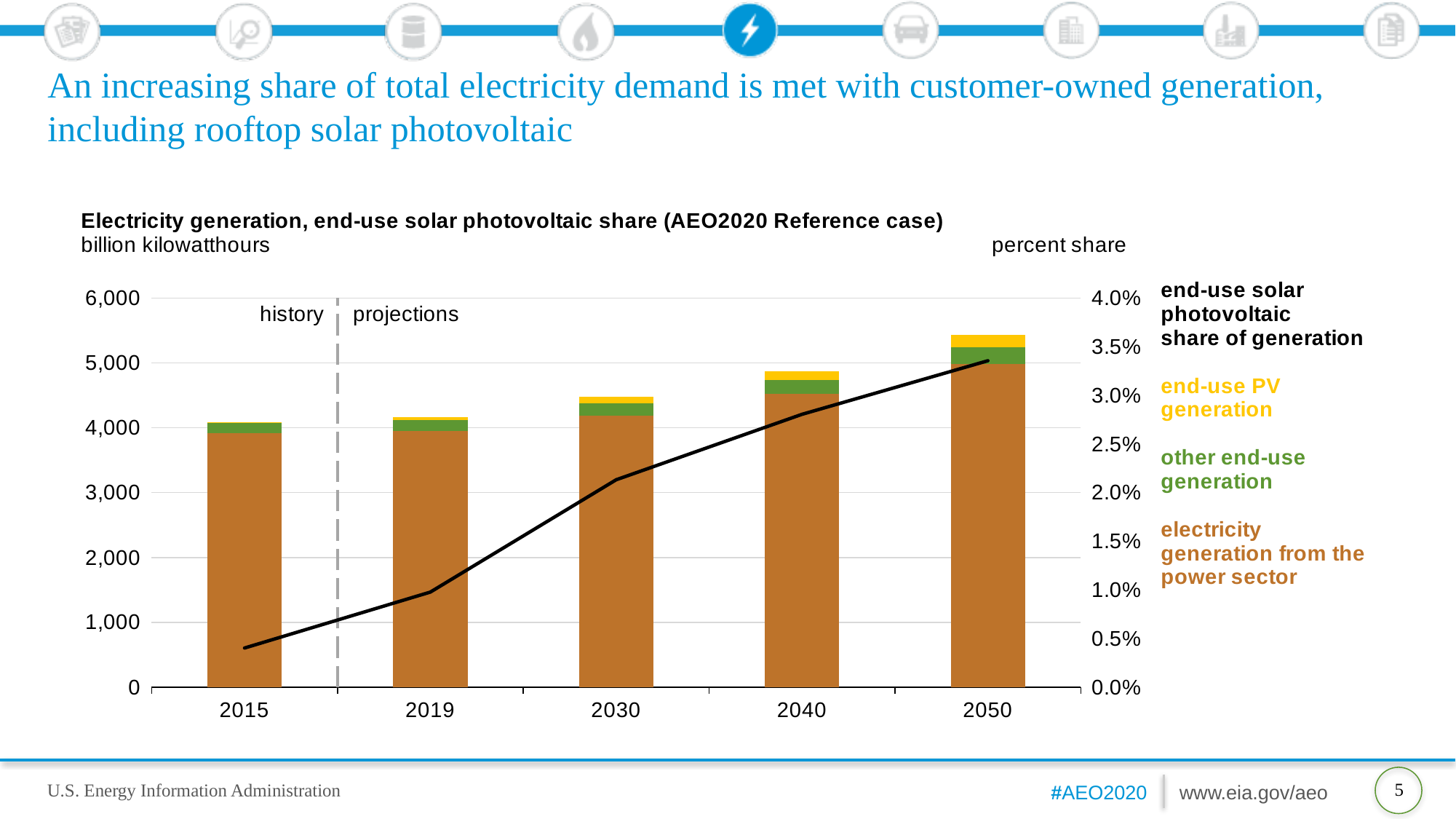
Is the end-use solar photovoltaic share of generation in 2015 greater or less than 0.5%? less Which is larger, the total stacked bar for 2050 or for 2030? 2050 How many years are shown on the x axis of the chart? 5 Is the total stacked bar for 2050 greater or less than 5,000 billion kilowatthours? greater What kind of chart is shown on the slide? stacked bar chart with a line What unit is shown on the left axis of the chart? billion kilowatthours Is the end-use solar photovoltaic share of generation in 2050 greater or less than 3.0%? greater How many entries does the chart's legend list? 4 Does the end-use solar photovoltaic share of generation line rise or fall from 2015 to 2050? rise Which year has the tallest stacked bar? 2050